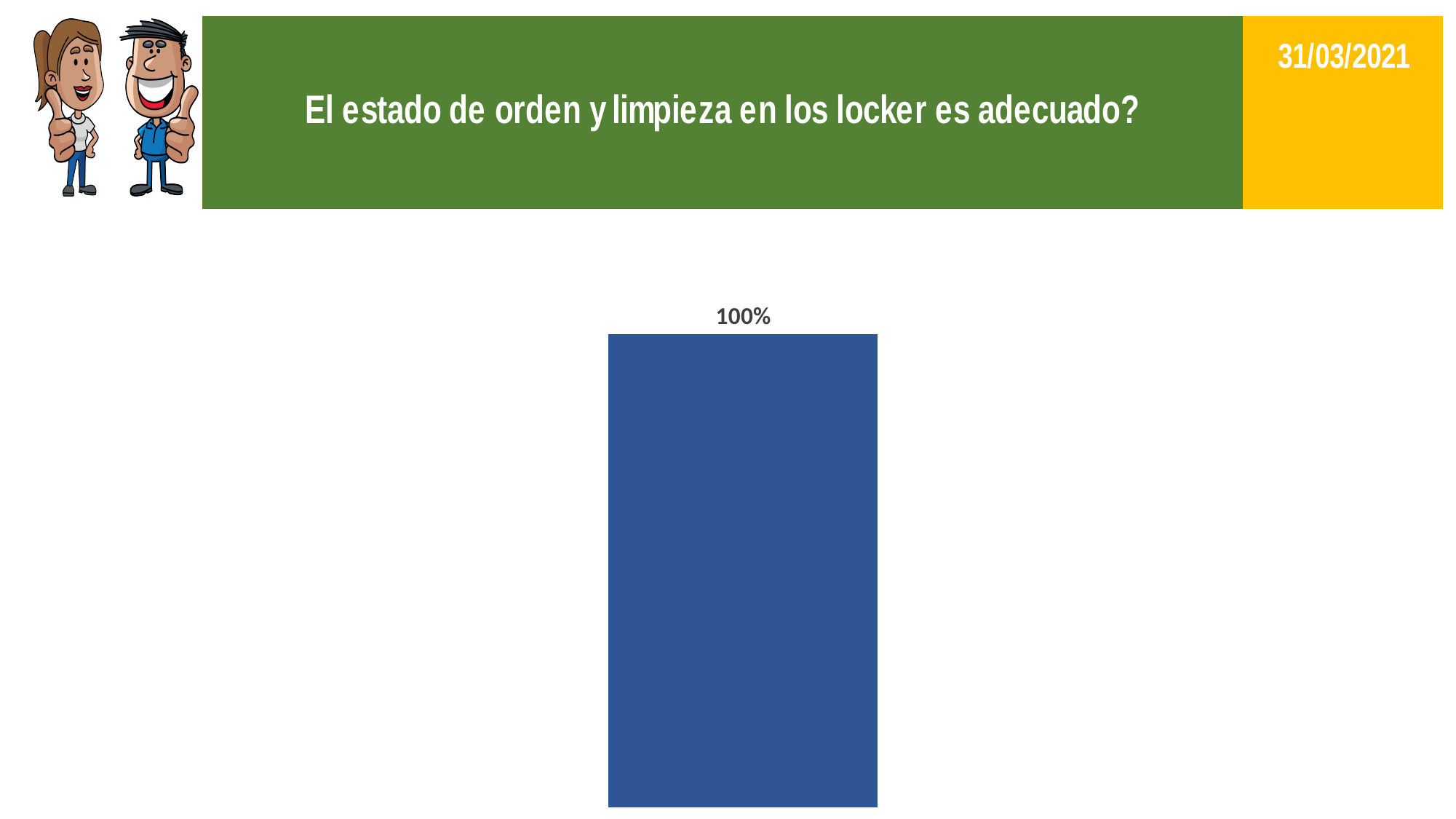
How many bars does the chart show? 1 Is the value shown on the bar greater or less than 50%? greater What kind of chart is shown on the slide? bar chart What colour is the bar in the chart? blue Does the chart include a legend? No What value is printed above the single bar in the chart? 100%